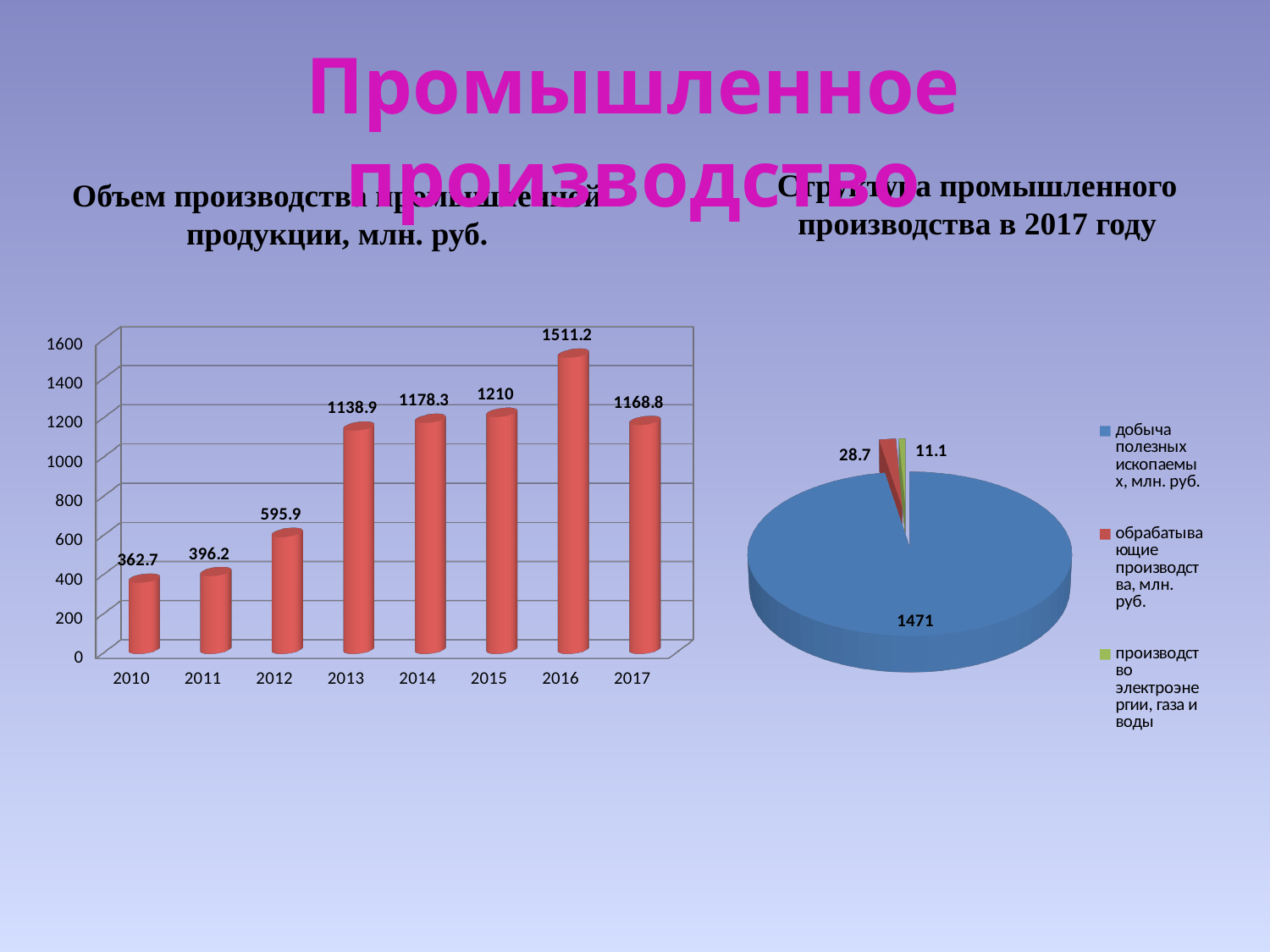
On the right pie chart, how many entries does the legend list? 3 On the left bar chart, do the values rise or fall from 2010 to 2016? rise On the left bar chart, which year has the highest value? 2016 What kind of chart is the chart on the left of the slide? bar chart On the left bar chart, which is larger, the value for 2014 or the value for 2017? 2014 On the left bar chart, what is the value for 2016? 1511.2 On the left bar chart, what is the value for 2013? 1138.9 On the left bar chart, how many years are shown on the x axis? 8 On the left bar chart, what is the value for 2010? 362.7 On the left bar chart, what is the difference between the values for 2016 and 2015? 301.2 On the right pie chart, what is the value for обрабатывающие производства? 28.7 On the left bar chart, which year has the lowest value? 2010